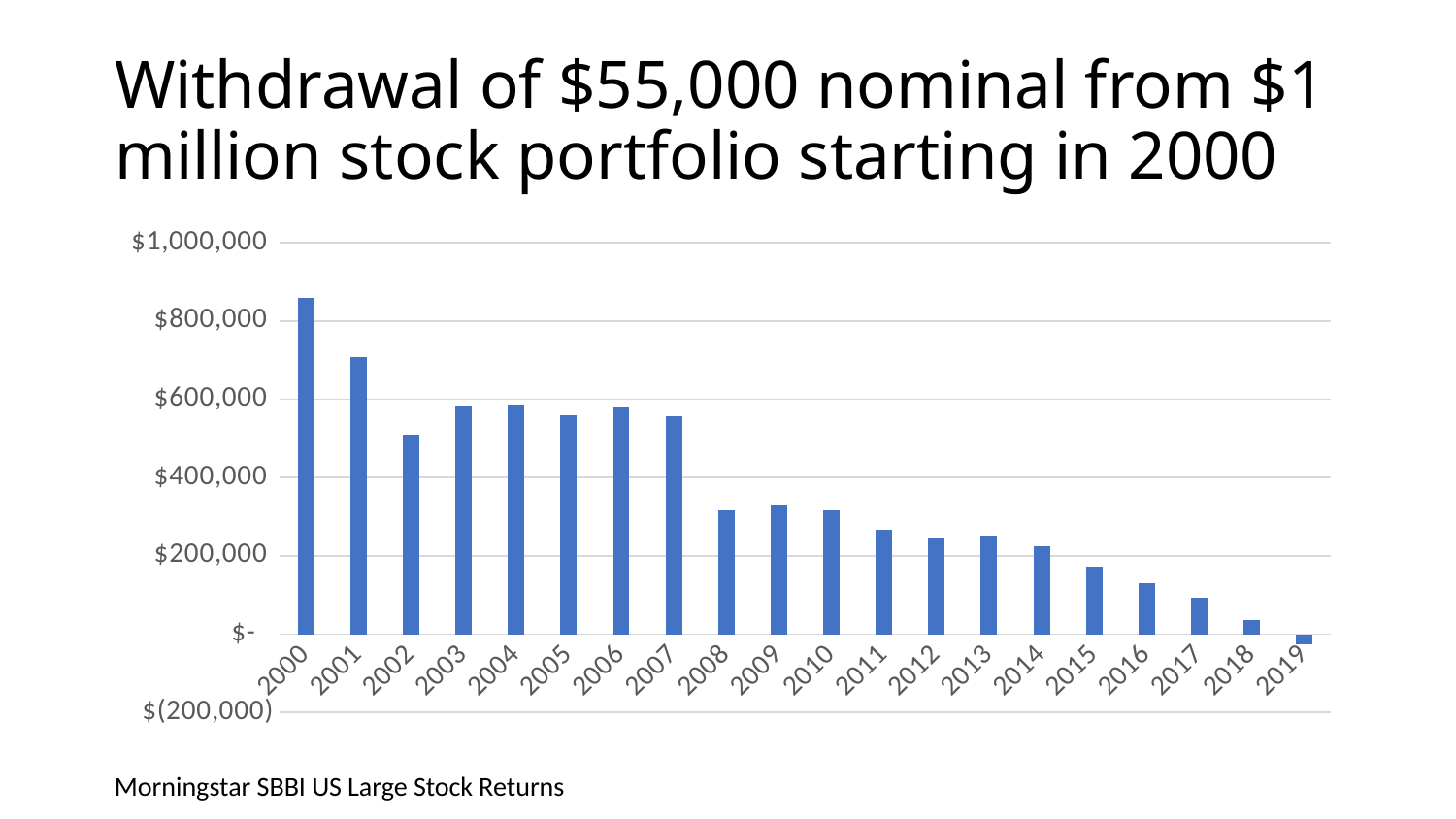
Which is larger, the value for 2002 or the value for 2003? 2003 Is the value for 2000 greater or less than $800,000? greater What kind of chart is shown on the slide? Bar chart Is the value for 2002 greater or less than $400,000? greater Do the values generally rise or fall from 2000 to 2019? Fall Which year has the highest portfolio value? 2000 Is the value for 2015 greater or less than $200,000? less Which year has the lowest portfolio value? 2019 How many years are plotted on the x axis? 20 What data source is cited below the chart? Morningstar SBBI US Large Stock Returns Which is larger, the value for 2014 or the value for 2016? 2014